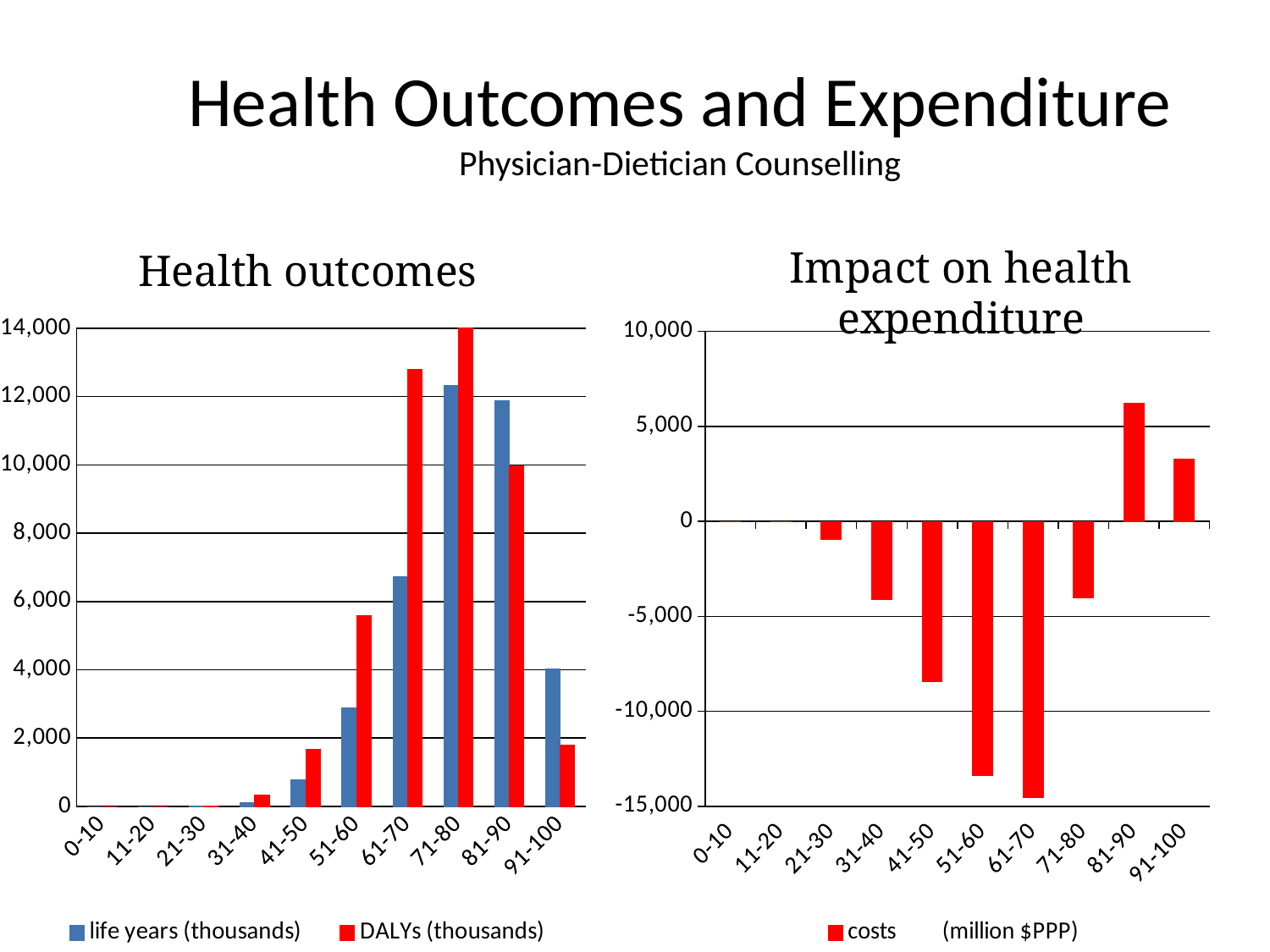
On the Impact on health expenditure chart, is the costs value for 91-100 greater or less than 5,000? less On the Health outcomes chart, which age group has the highest DALYs (thousands) value? 71-80 On the Impact on health expenditure chart, which age group has the highest costs value? 81-90 On the Impact on health expenditure chart, which age group has the lowest costs value? 61-70 What kind of chart is the Impact on health expenditure chart? bar chart On the Health outcomes chart, for the 61-70 age group, which is larger: life years (thousands) or DALYs (thousands)? DALYs (thousands) How many series does the legend of the Health outcomes chart list? 2 On the Health outcomes chart, for the 81-90 age group, which is larger: life years (thousands) or DALYs (thousands)? life years (thousands) On the Health outcomes chart, is the DALYs (thousands) value for 61-70 greater or less than 12,000? greater On the Health outcomes chart, is the life years (thousands) value for 51-60 greater or less than 4,000? less How many age-group categories are shown on the x axis of the Health outcomes chart? 10